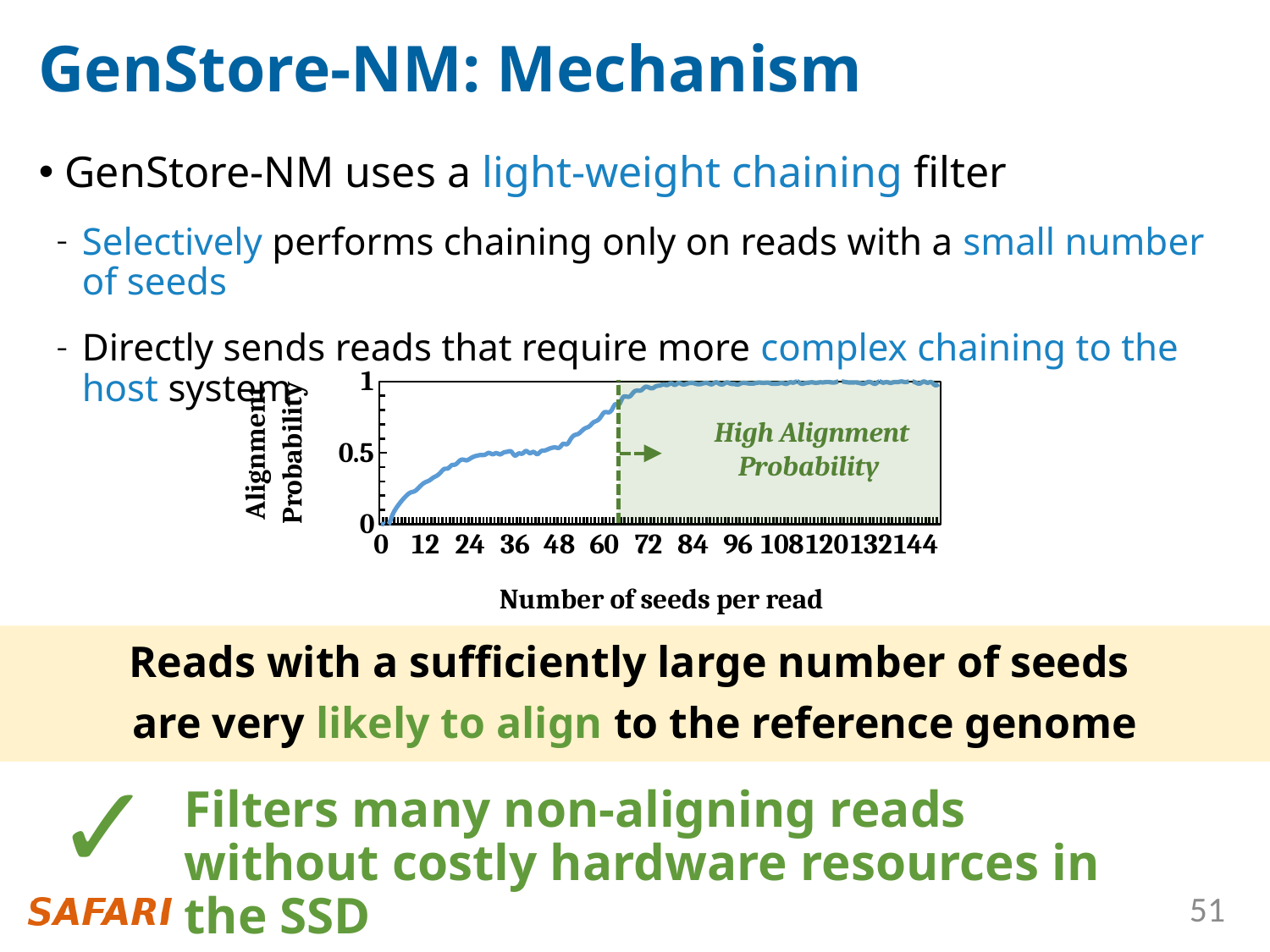
What is the label of the x axis of the chart? Number of seeds per read What is the largest tick value shown on the x axis of the chart? 144 Which is larger, the alignment probability at 12 seeds per read or at 84 seeds per read? 84 seeds per read Is the alignment probability at 120 seeds per read greater or less than 0.5? greater Is the alignment probability at 12 seeds per read greater or less than 0.5? less What kind of chart is shown on the slide? line chart Is the alignment probability at 96 seeds per read greater or less than 0.5? greater Does the alignment probability rise or fall as the number of seeds per read increases? rise How many tick labels are shown on the x axis of the chart? 13 What is the label of the y axis of the chart? Alignment Probability